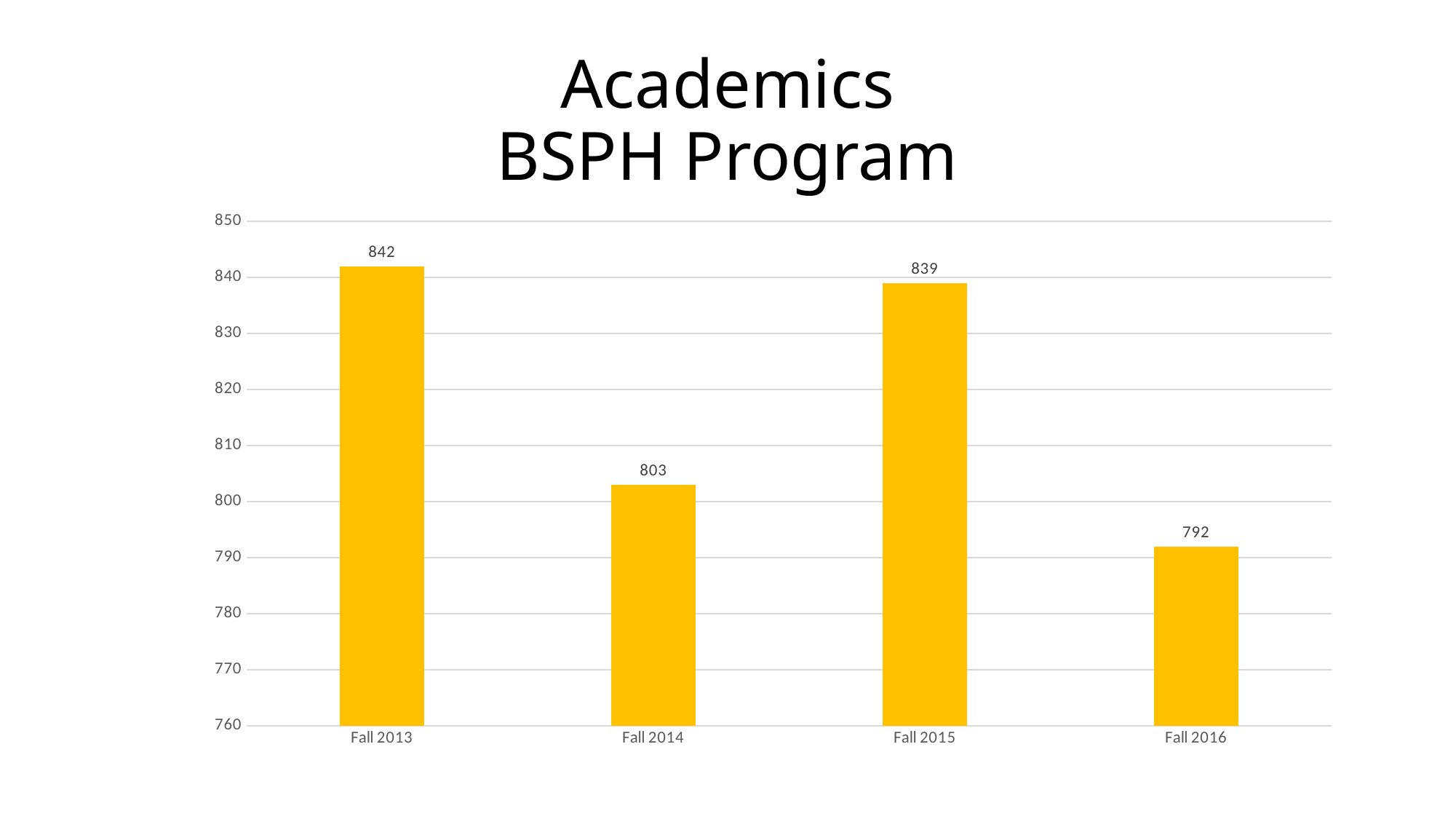
What is the value for Fall 2014? 803 Which category has the highest value? Fall 2013 Which category has the lowest value? Fall 2016 What is the difference between the values for Fall 2013 and Fall 2016? 50 What is the difference between the values for Fall 2015 and Fall 2014? 36 How many categories are shown on the x axis? 4 What is the value for Fall 2015? 839 What is the value for Fall 2016? 792 Which is larger, the value for Fall 2014 or the value for Fall 2015? Fall 2015 What is the value for Fall 2013? 842 What kind of chart is shown on the slide? bar chart Is the value for Fall 2016 greater or less than 800? less